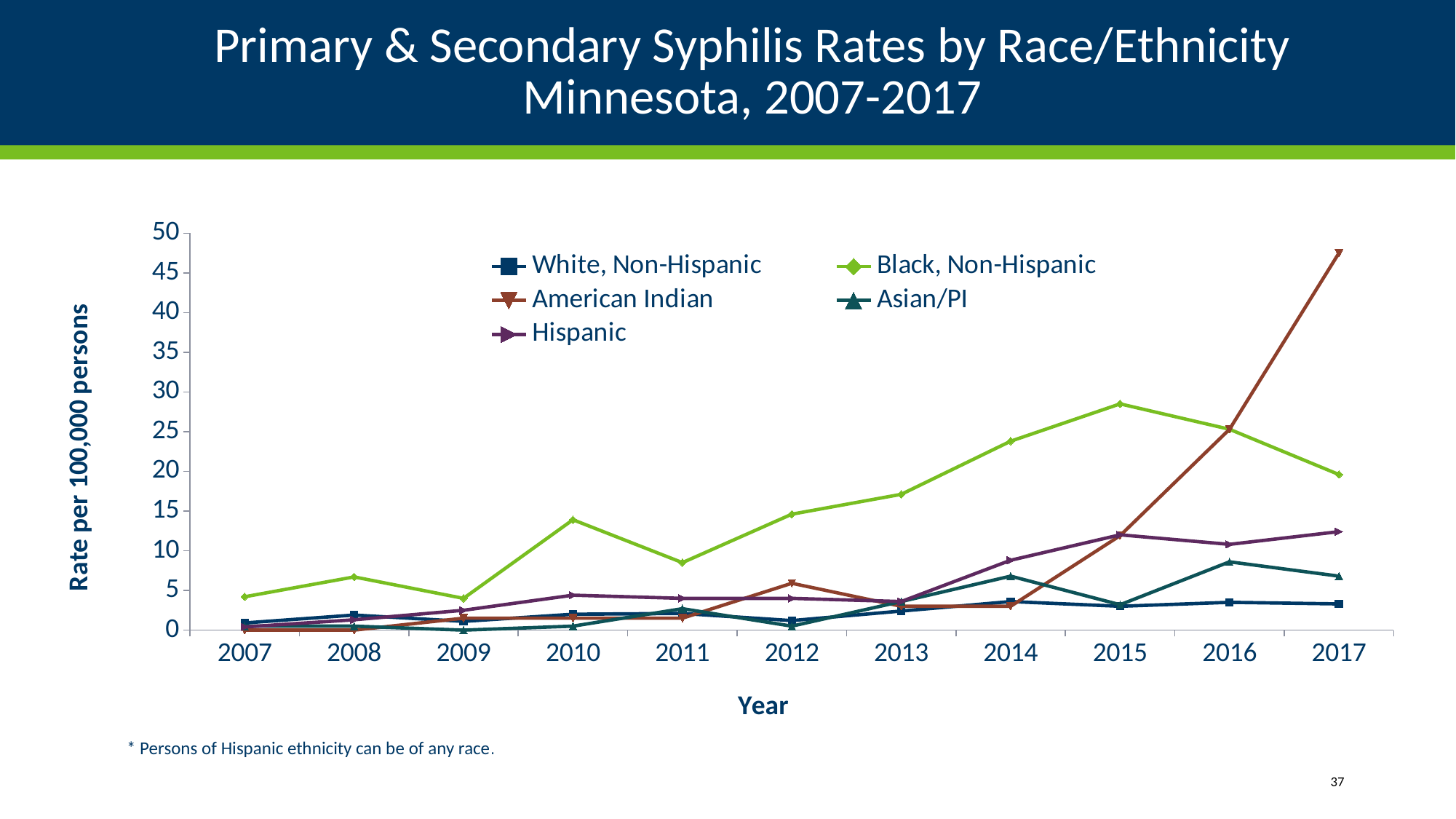
Which race/ethnicity group has the highest rate in 2017? American Indian How many series does the legend list? 5 Is the value for Asian/PI in 2016 greater or less than 10? less What is the title of the y axis? Rate per 100,000 persons Is the value for American Indian in 2017 greater or less than 45? greater Does the rate for American Indian rise or fall from 2014 to 2017? rise In 2014, which is higher: the rate for Black, Non-Hispanic or the rate for Hispanic? Black, Non-Hispanic Is the value for Black, Non-Hispanic in 2015 greater or less than 25? greater Which race/ethnicity group has the highest rate in 2015? Black, Non-Hispanic Which race/ethnicity group has the lowest rate in 2009? Asian/PI What kind of chart is shown on the slide? line chart How many years are plotted along the x axis? 11